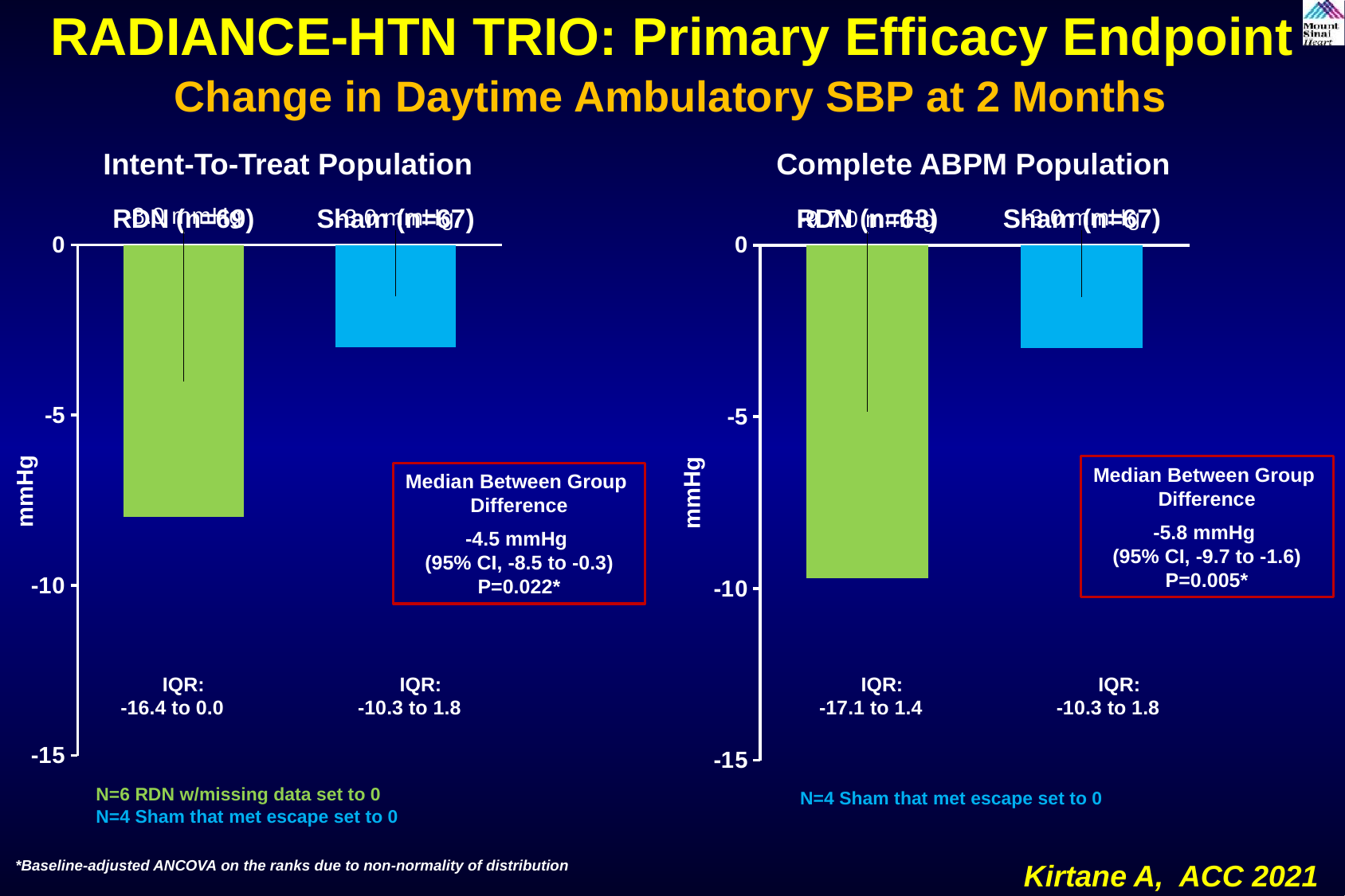
How many bars are shown on the Complete ABPM Population chart? 2 What median between group difference is reported in the box on the Complete ABPM Population chart? -5.8 mmHg On the Complete ABPM Population chart, which group has the highest (least negative) value? Sham (n=67) On the Complete ABPM Population chart, which bar extends further below zero, RDN (n=63) or Sham (n=67)? RDN (n=63) On the Intent-To-Treat Population chart, which group has the lowest (most negative) value? RDN (n=69) What kind of chart is the Intent-To-Treat Population chart? bar chart On the Complete ABPM Population chart, is the value for RDN (n=63) greater or less than -5? less On the Intent-To-Treat Population chart, is the value for RDN (n=69) greater or less than -5? less What unit is shown on the y axis of the Intent-To-Treat Population chart? mmHg On the Complete ABPM Population chart, is the value for Sham (n=67) greater or less than -5? greater